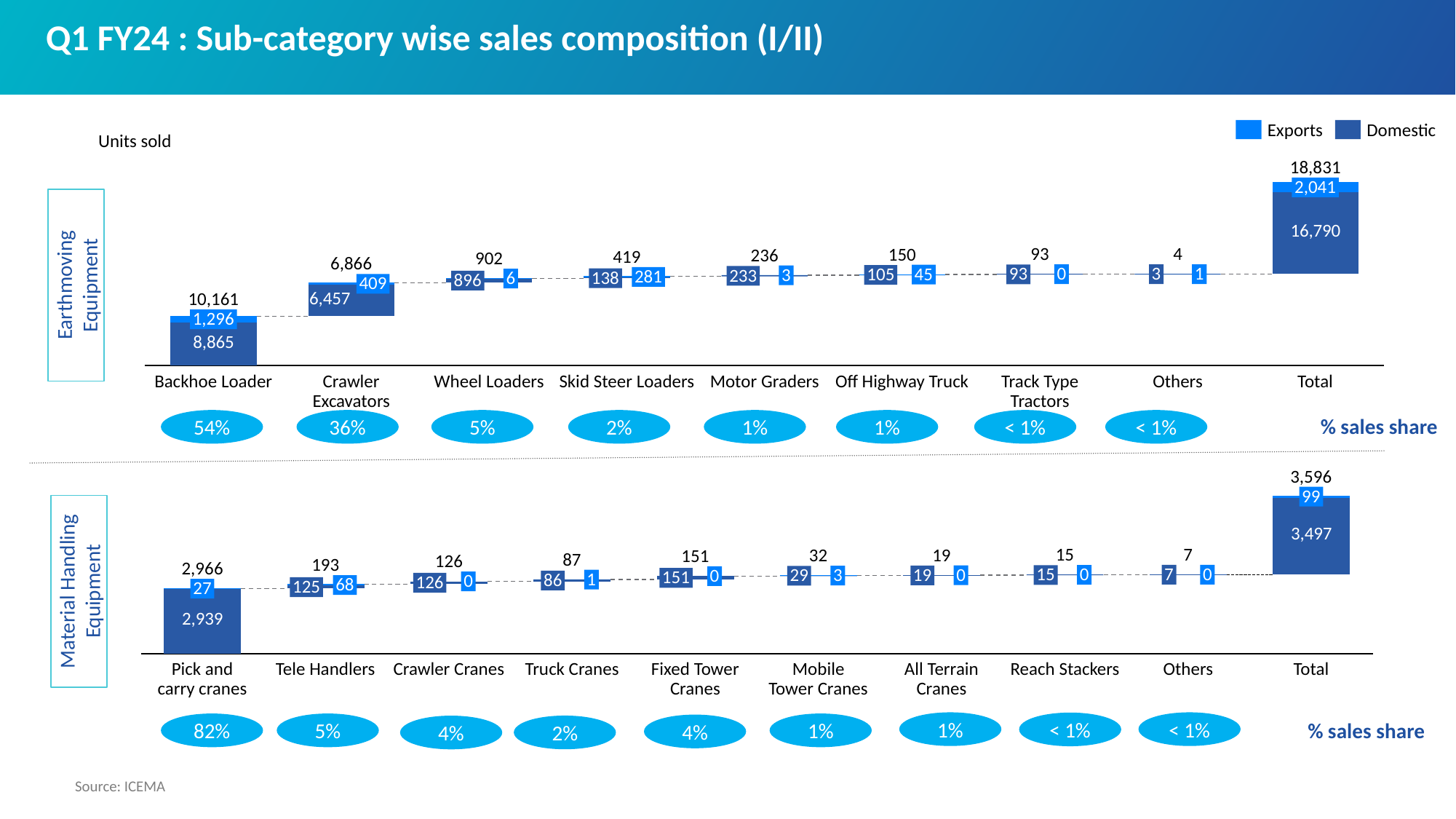
How many series does the legend list? 2 In the Earthmoving Equipment chart, which sub-category has the highest total units sold (excluding Total)? Backhoe Loader In the Material Handling Equipment chart, what is the Domestic value for Pick and carry cranes? 2,939 In the Earthmoving Equipment chart, what is the total units sold for Skid Steer Loaders? 419 In the Earthmoving Equipment chart, what is the Exports value for Crawler Excavators? 409 What kind of chart is used for the Material Handling Equipment data? Stacked bar chart In the Earthmoving Equipment chart, what is the Domestic value for Backhoe Loader? 8,865 In the Earthmoving Equipment chart, what is the difference between the Domestic and Exports values for Wheel Loaders? 890 In the Material Handling Equipment chart, which is larger: the total for Crawler Cranes or the total for Fixed Tower Cranes? Fixed Tower Cranes In the Material Handling Equipment chart, which sub-category has the lowest total units sold (excluding Total)? Others In the Earthmoving Equipment chart, what is the % sales share shown for Crawler Excavators? 36% In the Material Handling Equipment chart, what is the Exports value for Tele Handlers? 68